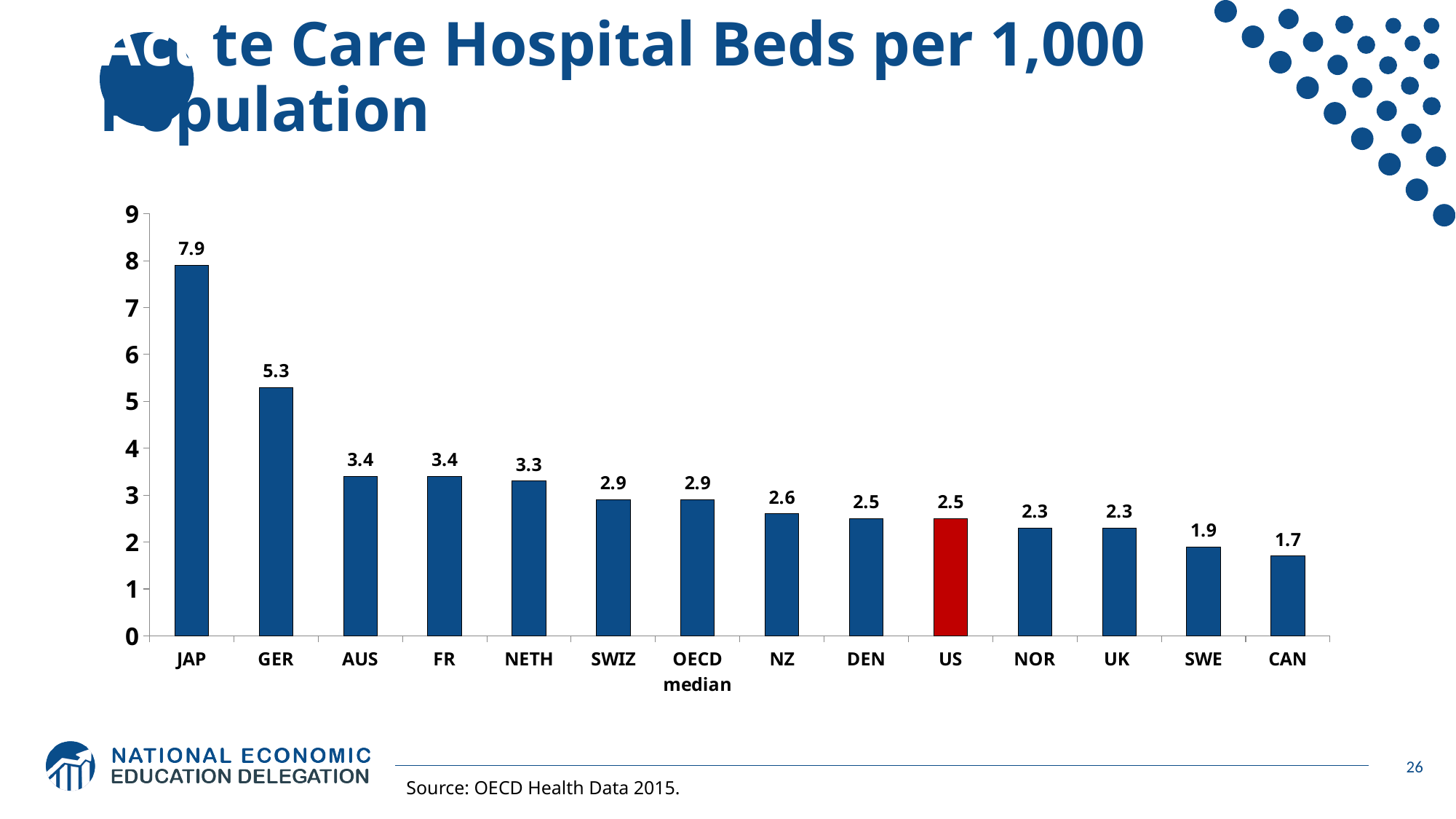
Which bar is coloured red rather than blue? US Which category has the highest value? JAP What is the value for the OECD median? 2.9 What is the difference between the OECD median and the US value? 0.4 Is the value for GER greater or less than 5? greater What is the value for the US? 2.5 What is the difference between the values for JAP and GER? 2.6 Which category has the lowest value? CAN How many categories are shown on the x axis? 14 What kind of chart is this? bar chart Which is larger, the value for NETH or the value for SWIZ? NETH What is the value for JAP? 7.9